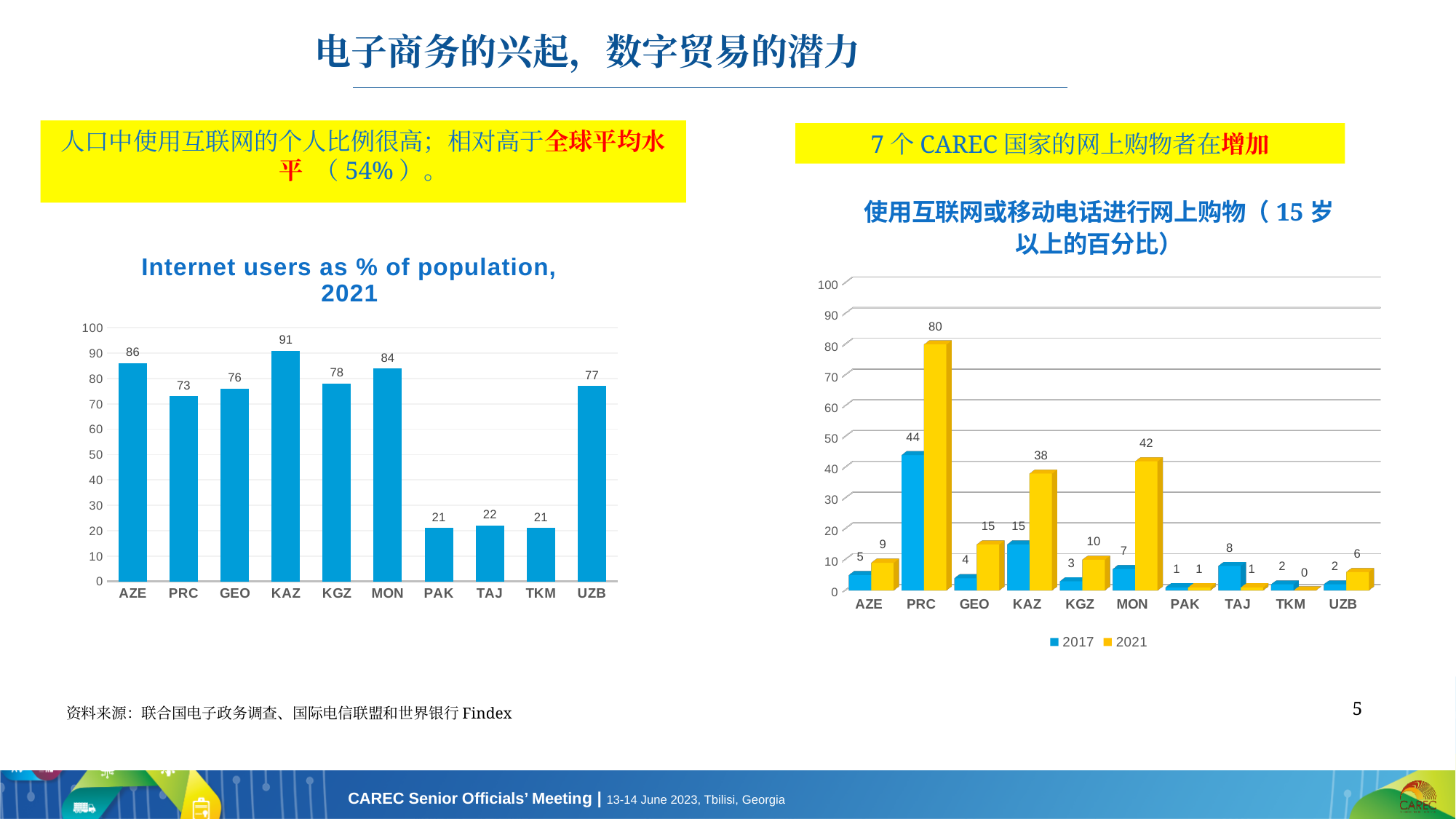
In the 'Internet users as % of population, 2021' chart, which country has the highest value? KAZ In the right-hand chart on online shopping, which country has the highest 2021 value? PRC In the right-hand chart on online shopping, how many series does the legend list? 2 In the right-hand chart on online shopping, what is the 2021 value for PRC? 80 What kind of chart is the 'Internet users as % of population, 2021' chart? Bar chart In the 'Internet users as % of population, 2021' chart, which is larger, the value for MON or the value for UZB? MON In the 'Internet users as % of population, 2021' chart, what is the difference between the values for AZE and PRC? 13 In the right-hand chart on online shopping, which colour represents the 2021 series? Yellow In the right-hand chart on online shopping, what is the difference between the 2021 and 2017 values for MON? 35 In the 'Internet users as % of population, 2021' chart, how many countries are shown on the x axis? 10 In the 'Internet users as % of population, 2021' chart, what is the value for KAZ? 91 In the right-hand chart on online shopping, what is the 2017 value for KAZ? 15